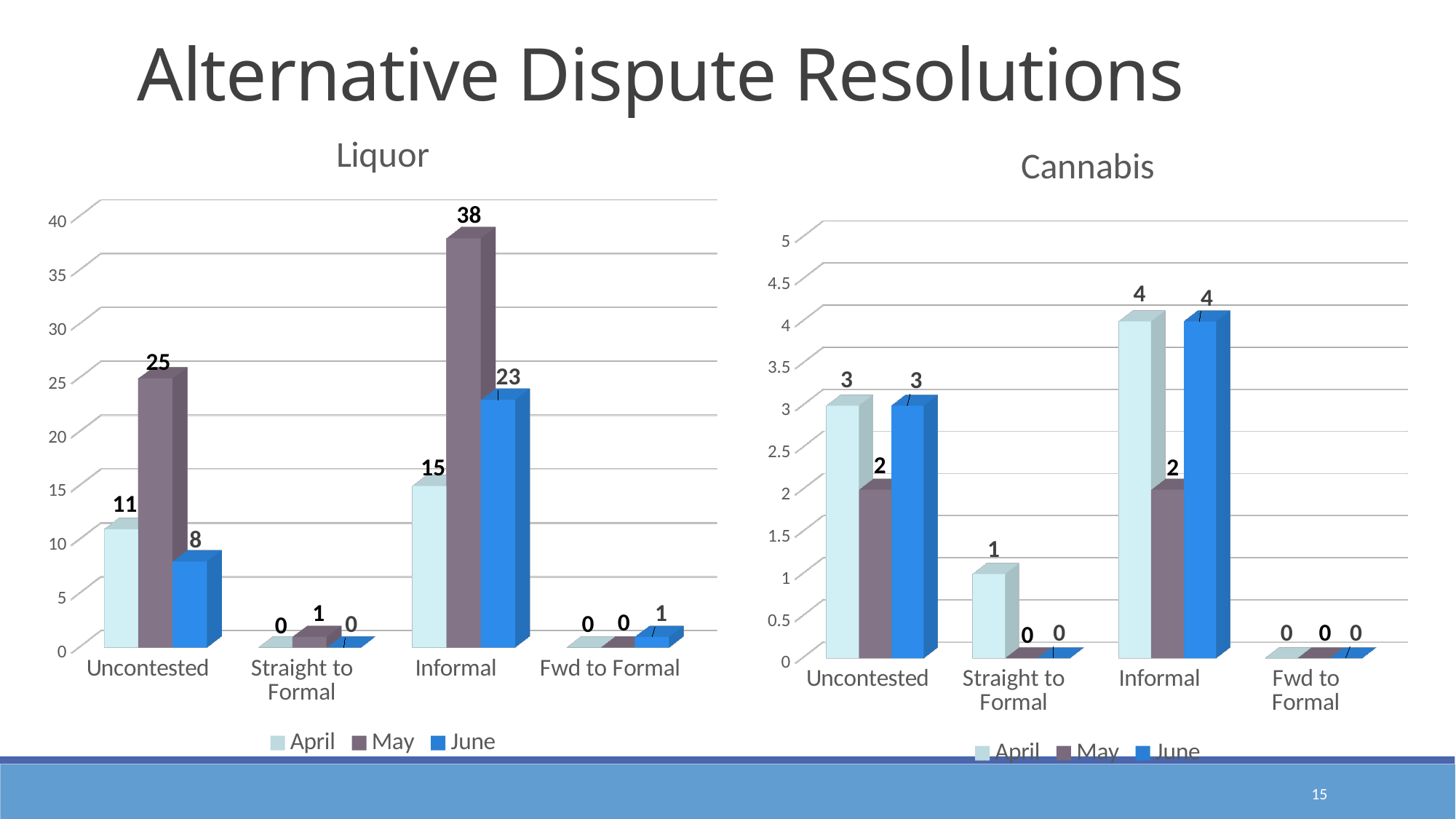
In the Liquor chart, how many categories are shown on the x axis? 4 In the Liquor chart, which category has the highest May value? Informal In the Liquor chart, what is the total of the April, May and June values for Informal? 76 What kind of chart is the Liquor chart? bar chart In the Cannabis chart, which category has the lowest April value? Fwd to Formal What is the title of the chart on the right side of the slide? Cannabis In the Cannabis chart, what is the value for April in the Informal category? 4 In the Liquor chart, what is the value for May in the Informal category? 38 In the Cannabis chart, is the April value for Uncontested larger or smaller than the May value for Uncontested? larger How many series does the legend of the Cannabis chart list? 3 In the Liquor chart, what is the difference between the May and April values for Uncontested? 14 In the Liquor chart, what is the value for June in the Uncontested category? 8